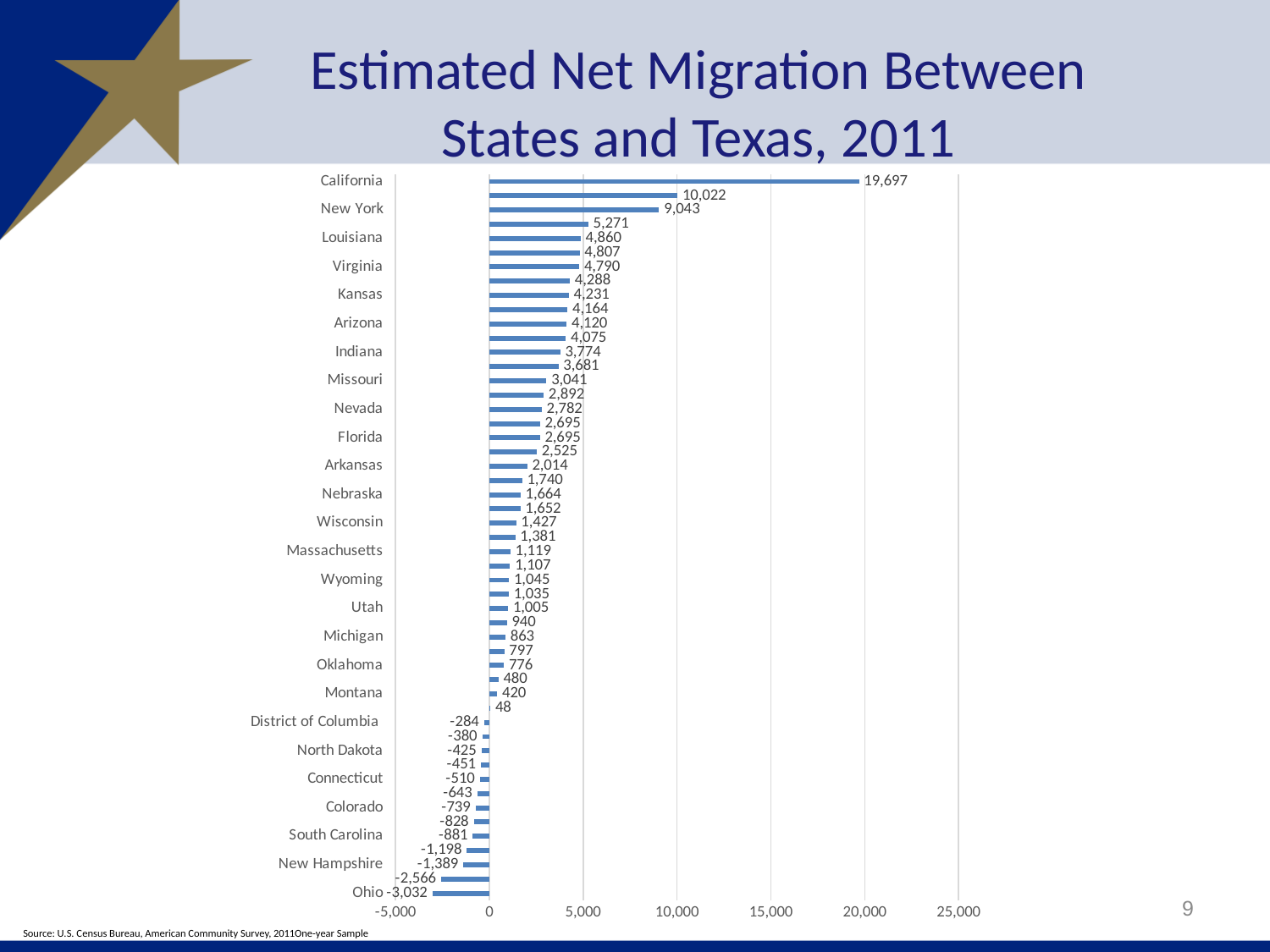
What is the value shown for Florida? 2,695 What is the difference between the values for California and New York? 10,654 Is the value for Missouri greater or less than 5,000? less Which labeled state has the lowest net migration value on the chart? Ohio What is the title of the chart? Estimated Net Migration Between States and Texas, 2011 What is the estimated net migration value for California? 19,697 Which has a larger value, Louisiana or Virginia? Louisiana Which state has the highest net migration value on the chart? California What is the value shown for Ohio? -3,032 What is the value shown for New York? 9,043 What type of chart is shown on the slide? bar chart What is the value shown for Colorado? -739